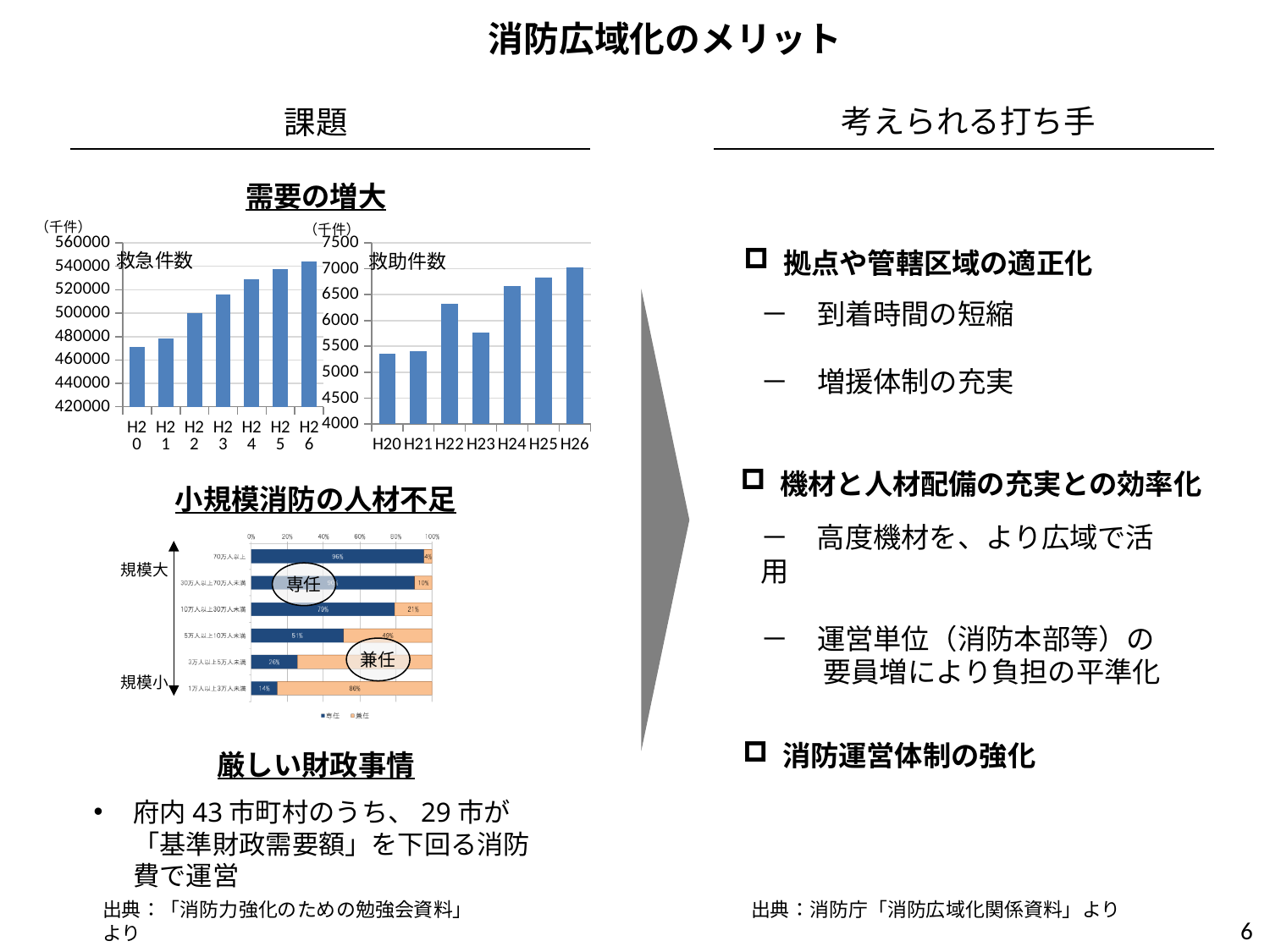
In the 救助件数 chart, is the value for H23 greater or less than 6000? less What kind of chart is the 救急件数 chart? bar chart In the 救急件数 chart, do the values rise or fall from H20 to H26? rise In the 救助件数 chart, which year has the highest value? H26 In the 小規模消防の人材不足 stacked bar chart, what is the 専任 percentage for 10万人以上30万人未満? 79% In the 救急件数 chart, which year has the lowest value? H20 In the 救助件数 chart, which is larger, the value for H22 or the value for H23? H22 In the 救急件数 chart, how many years (bars) are plotted? 7 In the 救急件数 chart, is the value for H22 greater or less than 480000? greater In the 小規模消防の人材不足 stacked bar chart, what is the 兼任 percentage for 1万人以上3万人未満? 86% In the 小規模消防の人材不足 stacked bar chart, how many series does the legend list? 2 In the 救急件数 chart, which year has the highest value? H26